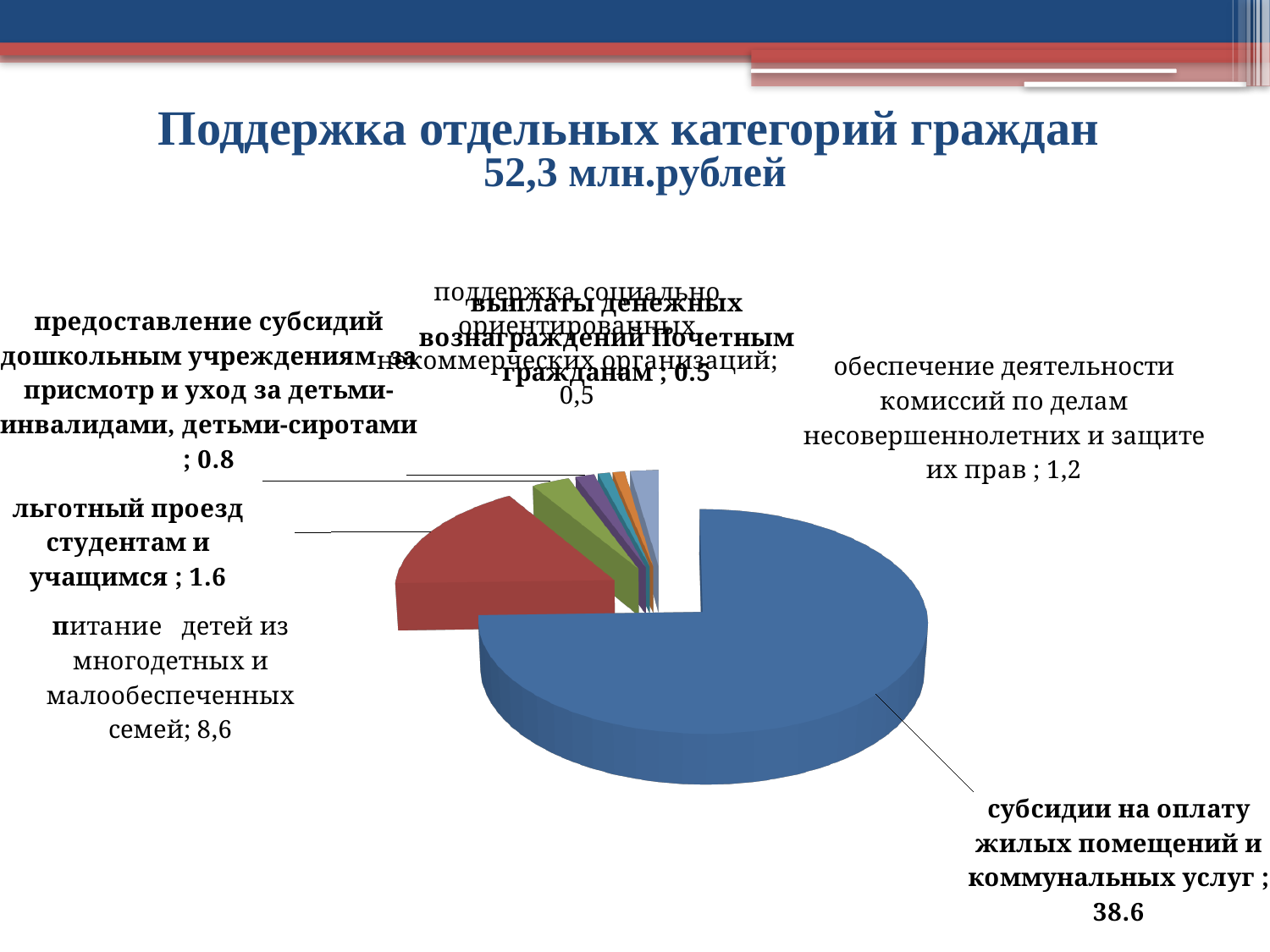
What kind of chart is shown on the slide? pie chart What total amount in million rubles is stated in the slide title? 52,3 млн.рублей What is the value for льготный проезд студентам и учащимся? 1.6 What is the value for выплаты денежных вознаграждений Почетным гражданам? 0.5 What is the value for питание детей из многодетных и малообеспеченных семей? 8,6 Which category has the largest slice of the pie? субсидии на оплату жилых помещений и коммунальных услуг What is the difference between the value for льготный проезд студентам и учащимся and the value for предоставление субсидий дошкольным учреждениям за присмотр и уход за детьми-инвалидами, детьми-сиротами? 0.8 What is the value for субсидии на оплату жилых помещений и коммунальных услуг? 38.6 What is the difference between the value for субсидии на оплату жилых помещений и коммунальных услуг and the value for питание детей из многодетных и малообеспеченных семей? 30 Which is larger: the value for льготный проезд студентам и учащимся or the value for обеспечение деятельности комиссий по делам несовершеннолетних и защите их прав? льготный проезд студентам и учащимся How many slices does the pie chart have? 7 What is the value for обеспечение деятельности комиссий по делам несовершеннолетних и защите их прав? 1,2